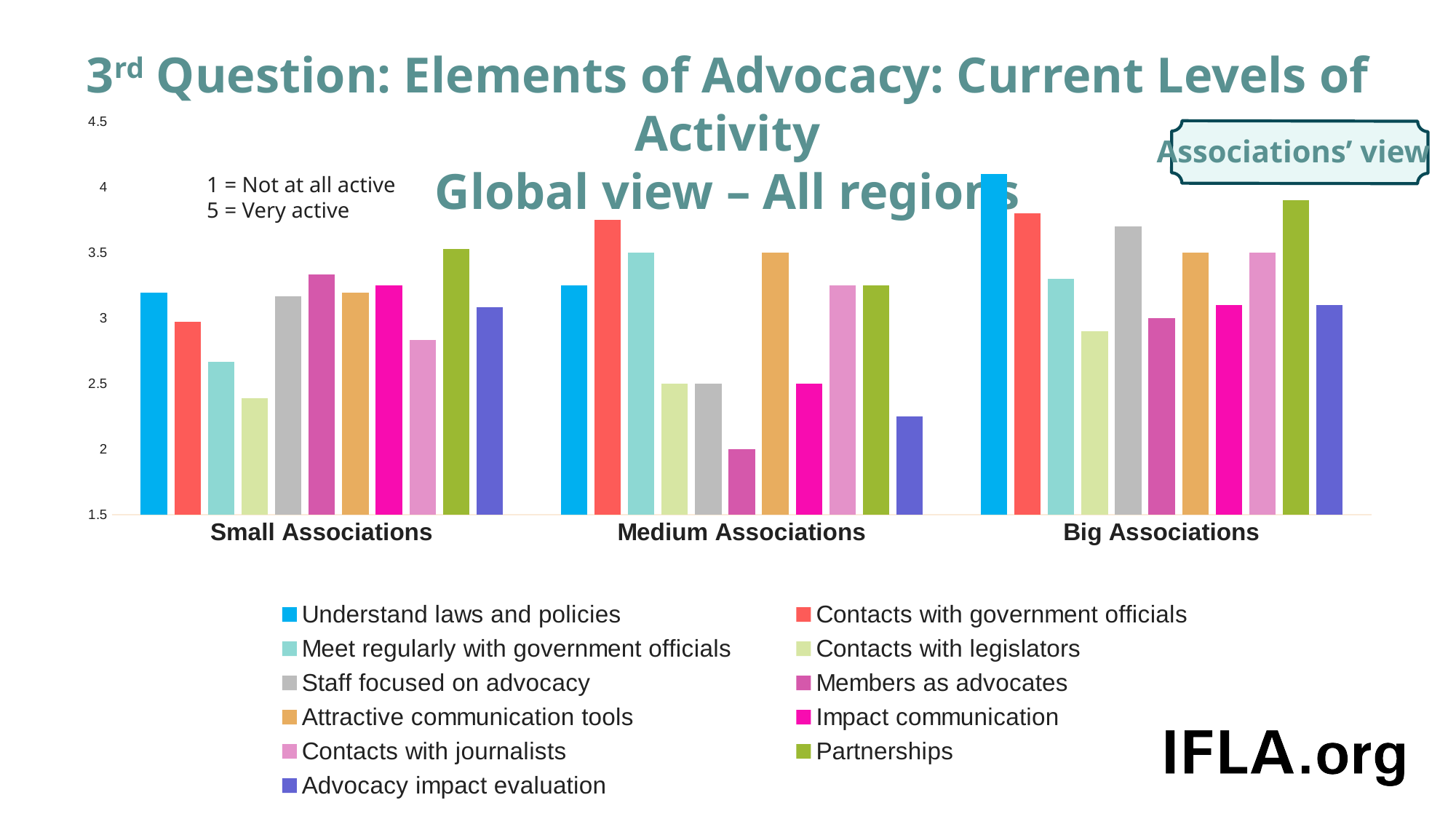
Which element has the lowest value for Small Associations? Contacts with legislators Which is larger: Partnerships for Big Associations or Partnerships for Medium Associations? Big Associations How many series does the legend list? 11 Which element has the highest value for Medium Associations? Contacts with government officials How many association size categories are shown on the x axis? 3 What kind of chart is shown on the slide? bar chart Does the value for Understand laws and policies rise or fall from Small Associations to Big Associations? rise Is the value for Staff focused on advocacy in Big Associations greater or less than 3.5? greater Which element has the highest value for Big Associations? Understand laws and policies Is the value for Understand laws and policies in Small Associations greater or less than 3? greater Is the value for Advocacy impact evaluation in Medium Associations greater or less than 2.5? less Which element has the lowest value for Medium Associations? Members as advocates